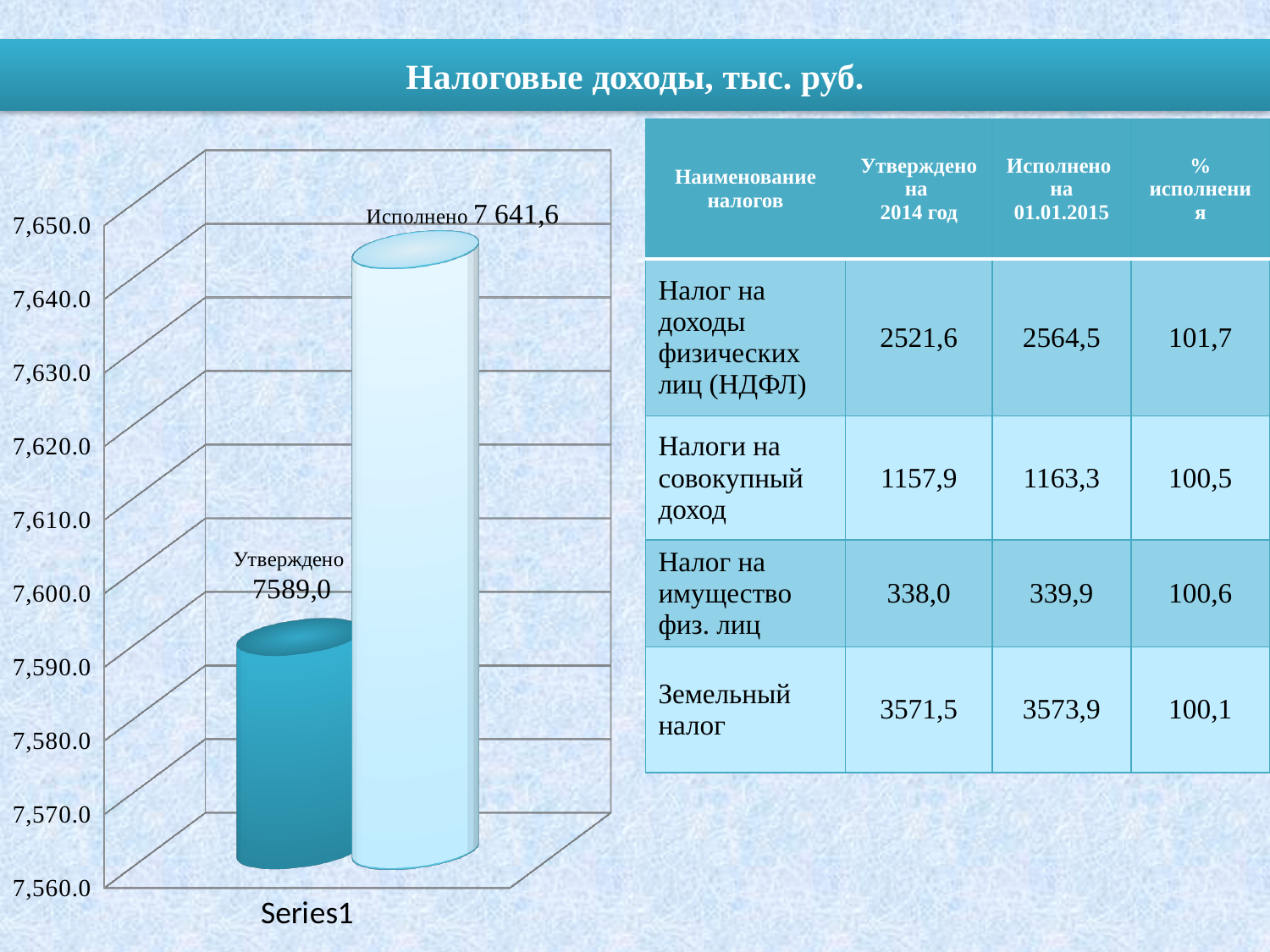
Which bar is higher, Утверждено or Исполнено? Исполнено What value is shown for the Исполнено bar? 7 641,6 Is the value for Утверждено greater or less than the value for Исполнено? less What value is shown for the Утверждено bar? 7589,0 By how much does the Исполнено value exceed the Утверждено value? 52,6 Is the value for Исполнено greater or less than 7,620.0? greater Is the value for Утверждено greater or less than 7,600.0? less What kind of chart is shown on the slide? bar chart What is the title of the slide above the chart? Налоговые доходы, тыс. руб. What label appears on the horizontal axis of the chart? Series1 Which bar has the lowest value? Утверждено How many bars are plotted in the chart? 2